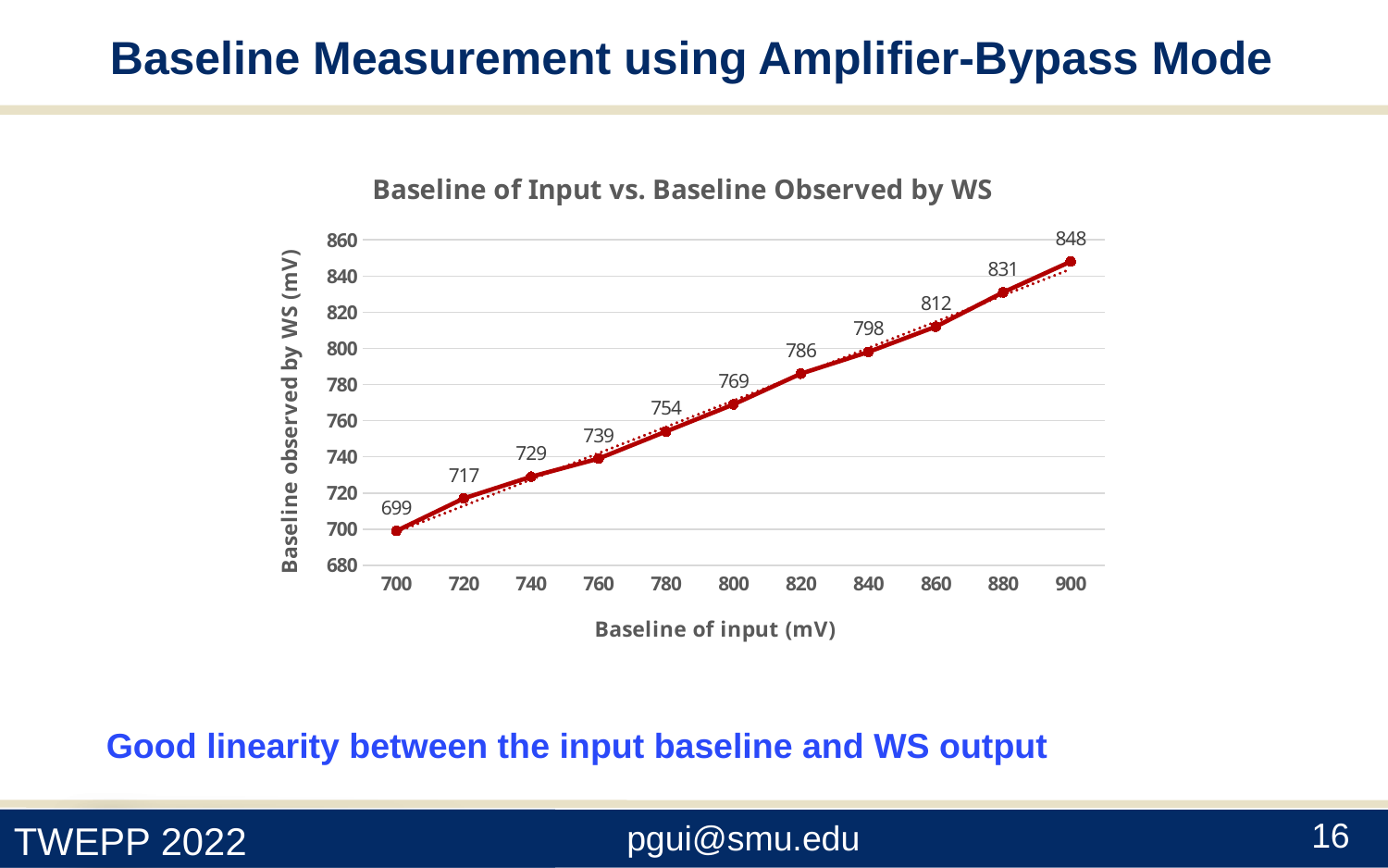
Which is larger: the baseline observed by WS at 840 mV input or at 860 mV input? 860 mV input What is the baseline observed by WS when the baseline of input is 900 mV? 848 How many data points are plotted on the chart? 11 At which baseline of input is the baseline observed by WS lowest? 700 Do the values rise or fall as the baseline of input increases? rise At which baseline of input is the baseline observed by WS highest? 900 What is the baseline observed by WS when the baseline of input is 700 mV? 699 Is the baseline observed by WS at 820 mV input greater or less than 800? less What is the baseline observed by WS when the baseline of input is 800 mV? 769 What kind of chart is shown on the slide? line chart What is the difference between the baseline observed by WS at 900 mV input and at 700 mV input? 149 What is the title of the chart? Baseline of Input vs. Baseline Observed by WS